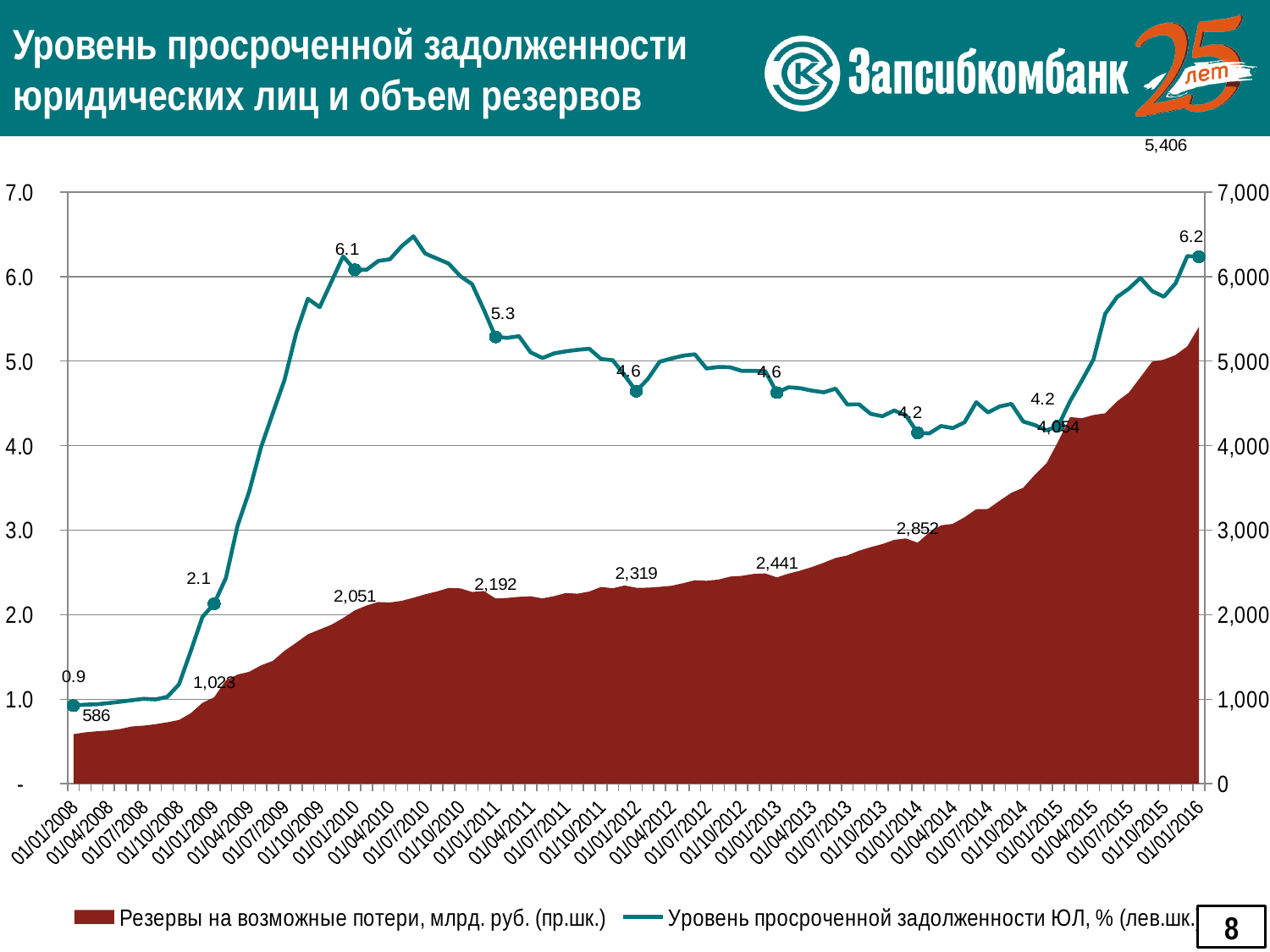
How many series does the legend list? 2 What colour is the area showing reserves (Резервы на возможные потери)? Dark red What is the difference between the overdue debt level on 01/01/2010 and on 01/01/2009? 4.0 Which is larger: the overdue debt level on 01/01/2011 or on 01/01/2012? 01/01/2011 Among the labelled points, which date has the lowest reserves value? 01/01/2008 What is the value of reserves (Резервы на возможные потери) on 01/01/2014? 2,852 What is the difference between the reserves on 01/01/2016 and on 01/01/2015? 1,352 What is the overdue debt level (%) on 01/01/2008? 0.9 Among the labelled points, which date has the highest overdue debt level (%)? 01/01/2016 Is the overdue debt level on 01/07/2010 greater or less than 6.0? greater What is the value of reserves (Резервы на возможные потери) on 01/01/2016? 5,406 What is the value of the overdue debt level (Уровень просроченной задолженности ЮЛ, %) on 01/01/2010? 6.1